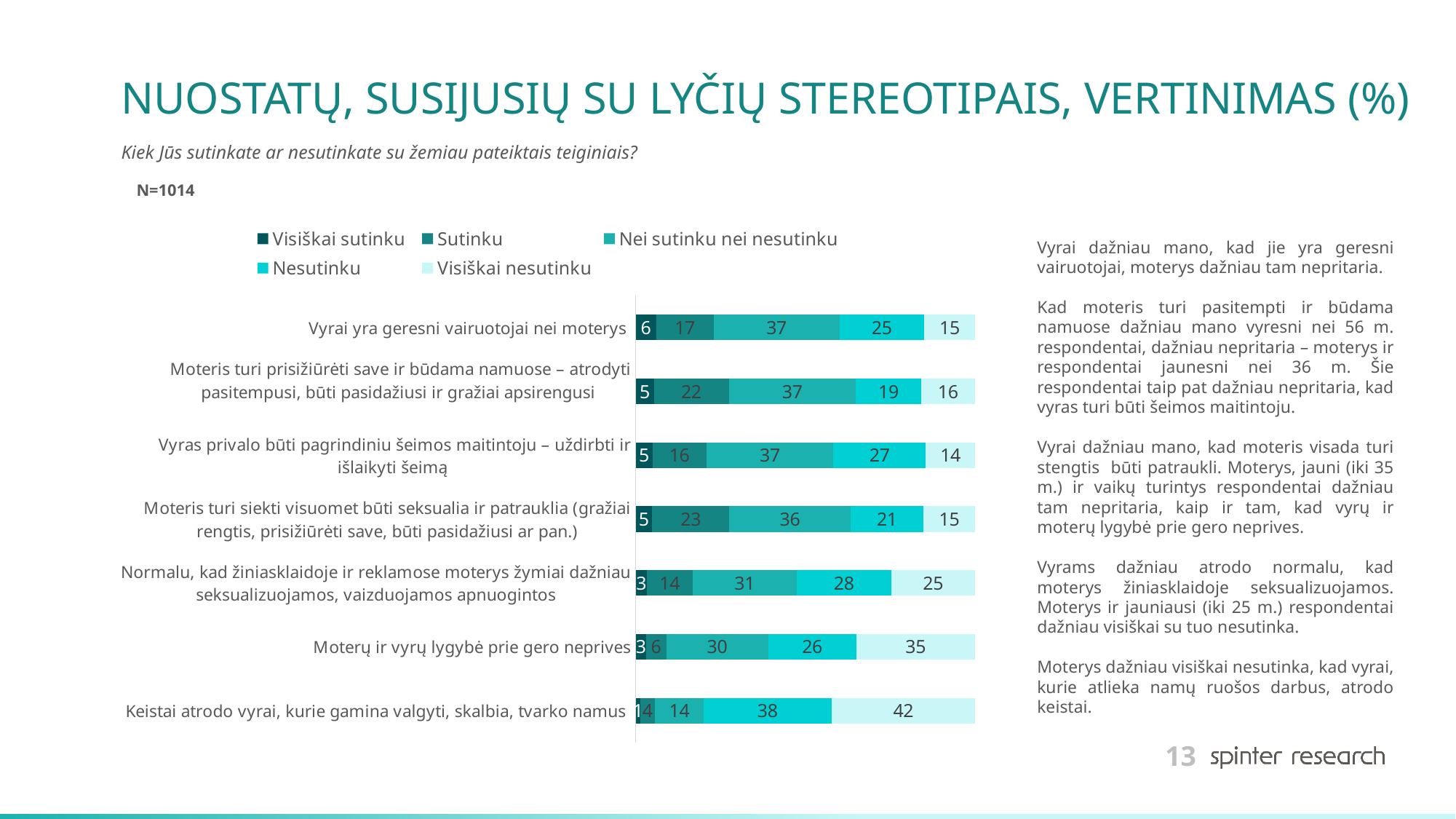
What is the 'Visiškai nesutinku' value for 'Keistai atrodo vyrai, kurie gamina valgyti, skalbia, tvarko namus'? 42 What is the 'Sutinku' value for 'Moteris turi siekti visuomet būti seksualia ir patrauklia (gražiai rengtis, prisižiūrėti save, būti pasidažiusi ar pan.)'? 23 What is the 'Nei sutinku nei nesutinku' value for 'Vyrai yra geresni vairuotojai nei moterys'? 37 Which statement has the highest 'Visiškai nesutinku' value? Keistai atrodo vyrai, kurie gamina valgyti, skalbia, tvarko namus What kind of chart is shown on the slide? Stacked bar chart How many statements (categories) are plotted in the chart? 7 Which statement has the highest 'Visiškai sutinku' value? Vyrai yra geresni vairuotojai nei moterys What is the difference between the 'Visiškai nesutinku' values for 'Moterų ir vyrų lygybė prie gero neprives' and 'Vyrai yra geresni vairuotojai nei moterys'? 20 What sample size (N) is stated on the slide? N=1014 How many series does the legend list? 5 What is the total of the stacked bar for 'Moterų ir vyrų lygybė prie gero neprives'? 100 Which is larger: the 'Nesutinku' value for 'Vyras privalo būti pagrindiniu šeimos maitintoju – uždirbti ir išlaikyti šeimą' or for 'Moteris turi prisižiūrėti save ir būdama namuose – atrodyti pasitempusi, būti pasidažiusi ir gražiai apsirengusi'? Vyras privalo būti pagrindiniu šeimos maitintoju – uždirbti ir išlaikyti šeimą